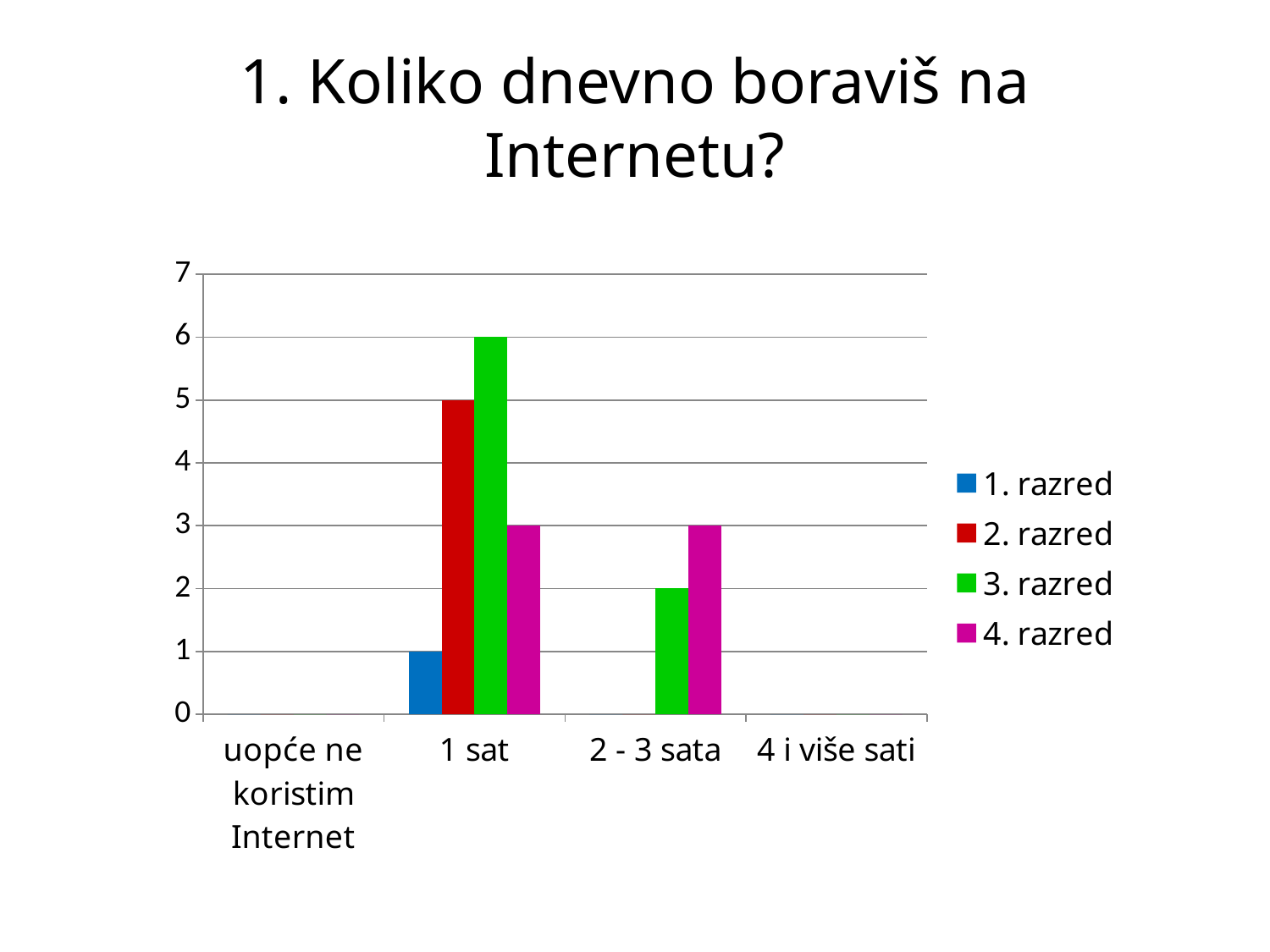
In the '2 - 3 sata' category, which is larger: the value for 3. razred or for 4. razred? 4. razred Which series has the highest value in the '1 sat' category? 3. razred What is the value for 1. razred in the '1 sat' category? 1 What is the difference between the 3. razred and 2. razred values in the '1 sat' category? 1 How many categories are shown on the x axis? 4 What is the title of the chart? 1. Koliko dnevno boraviš na Internetu? What is the value for 3. razred in the '1 sat' category? 6 How many series does the legend list? 4 What is the value for 2. razred in the '1 sat' category? 5 Is the value for 3. razred in the '1 sat' category greater or less than 4? greater What kind of chart is shown on the slide? bar chart What is the value for 4. razred in the '2 - 3 sata' category? 3